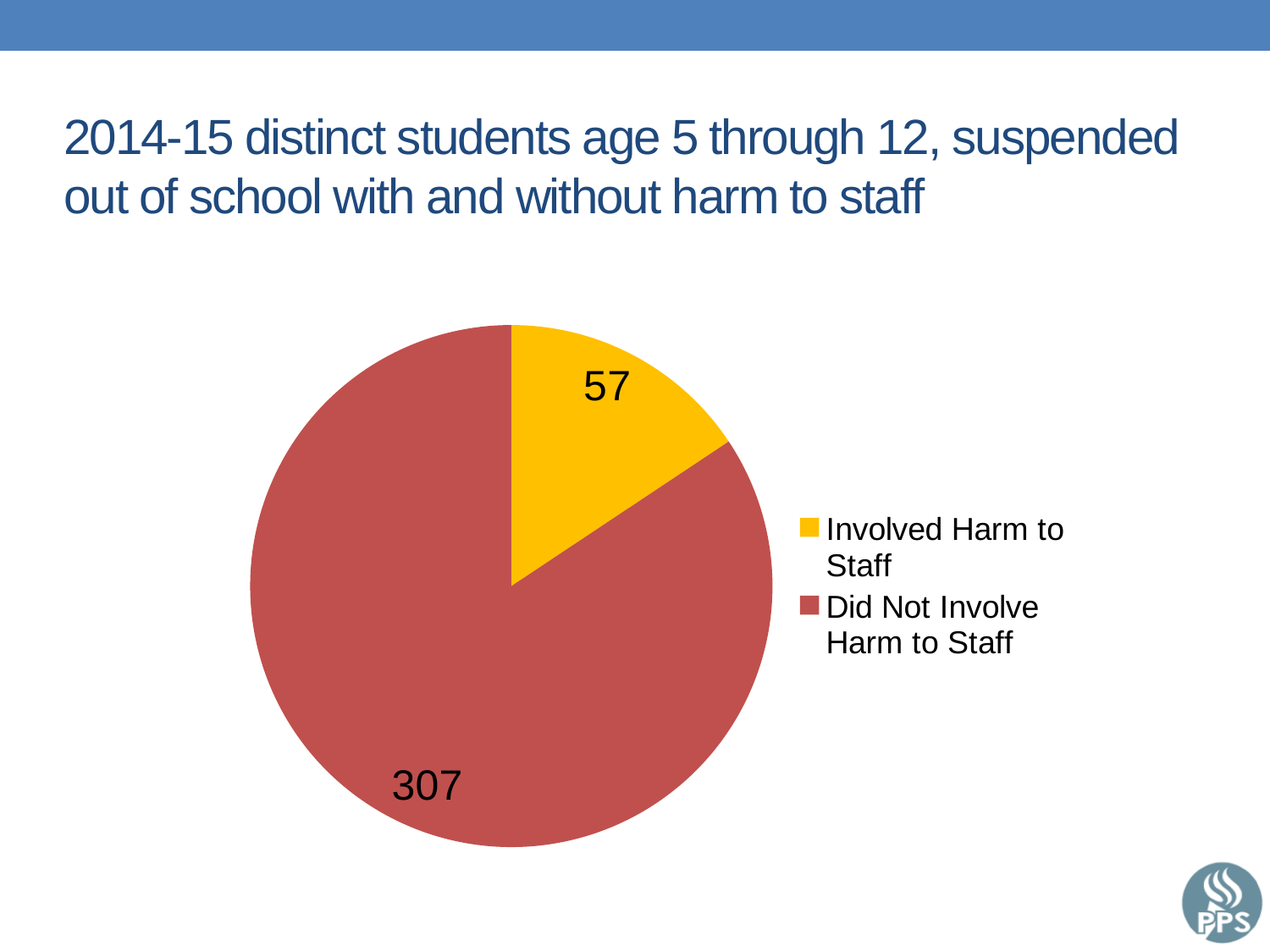
What is the difference between the 'Did Not Involve Harm to Staff' and 'Involved Harm to Staff' values? 250 Which slice of the pie is the largest? Did Not Involve Harm to Staff What is the total number of students represented in the pie chart? 364 What colour is the 'Involved Harm to Staff' slice? Yellow How many slices does the pie chart have? 2 How many students are in the 'Involved Harm to Staff' slice? 57 How many entries does the legend list? 2 Which slice of the pie is the smallest? Involved Harm to Staff What kind of chart is shown on the slide? Pie chart Which is larger: 'Involved Harm to Staff' or 'Did Not Involve Harm to Staff'? Did Not Involve Harm to Staff How many students are in the 'Did Not Involve Harm to Staff' slice? 307